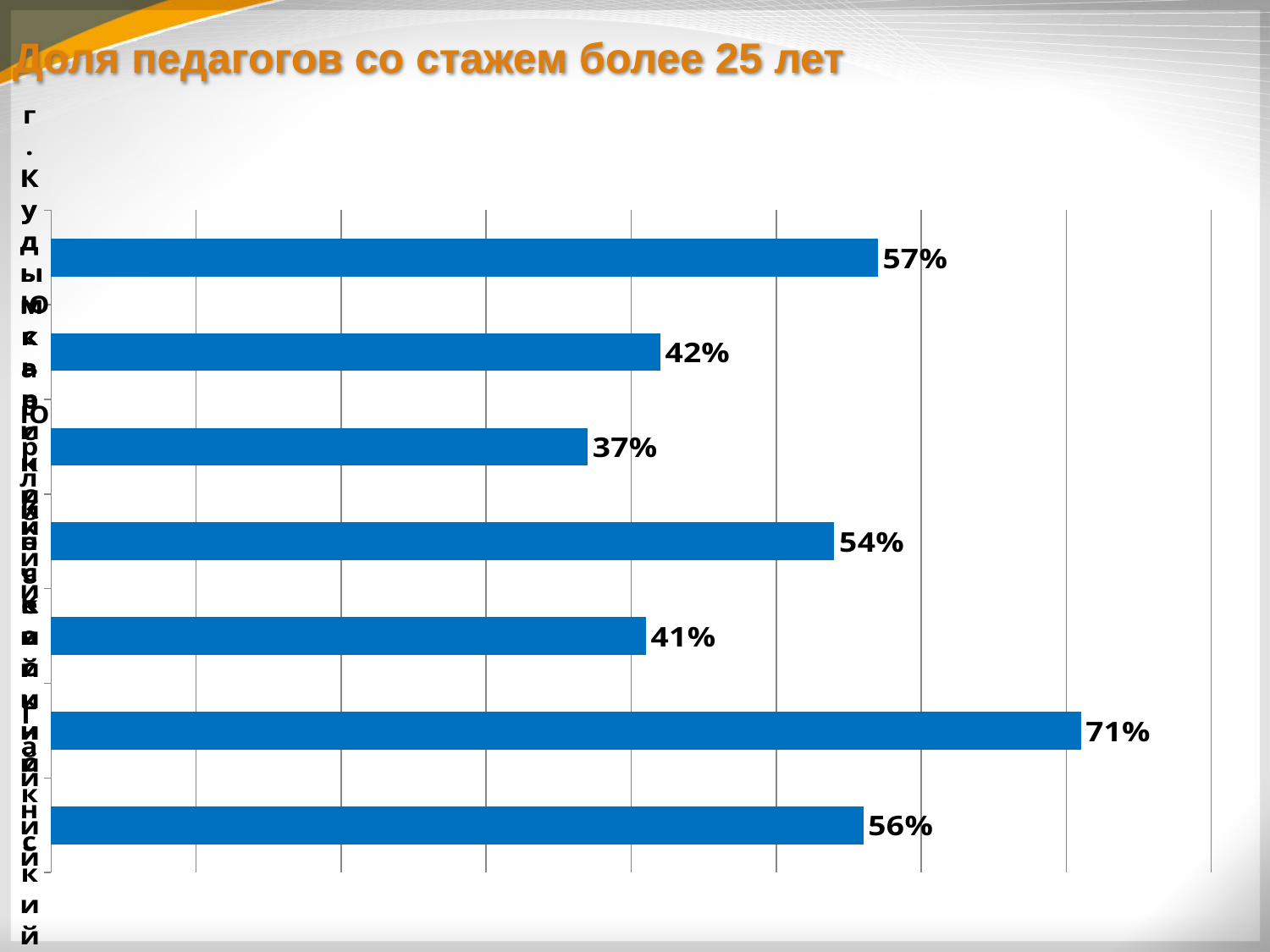
What kind of chart is shown on the slide? bar chart How many bars does the chart contain? 7 What is the highest value shown in the chart? 71% What is the title of the chart? Доля педагогов со стажем более 25 лет What is the value of the sixth bar from the top? 71% What is the difference between the largest value (71%) and the smallest value (37%) in the chart? 34% Which is larger: the value of the second bar from the top (42%) or the fifth bar from the top (41%)? the second bar from the top (42%) What is the value of the bottom bar in the chart? 56% What is the value of the topmost bar in the chart? 57% What is the difference between the fourth bar from the top (54%) and the bottom bar (56%)? 2% What is the value of the third bar from the top? 37% What is the lowest value shown in the chart? 37%